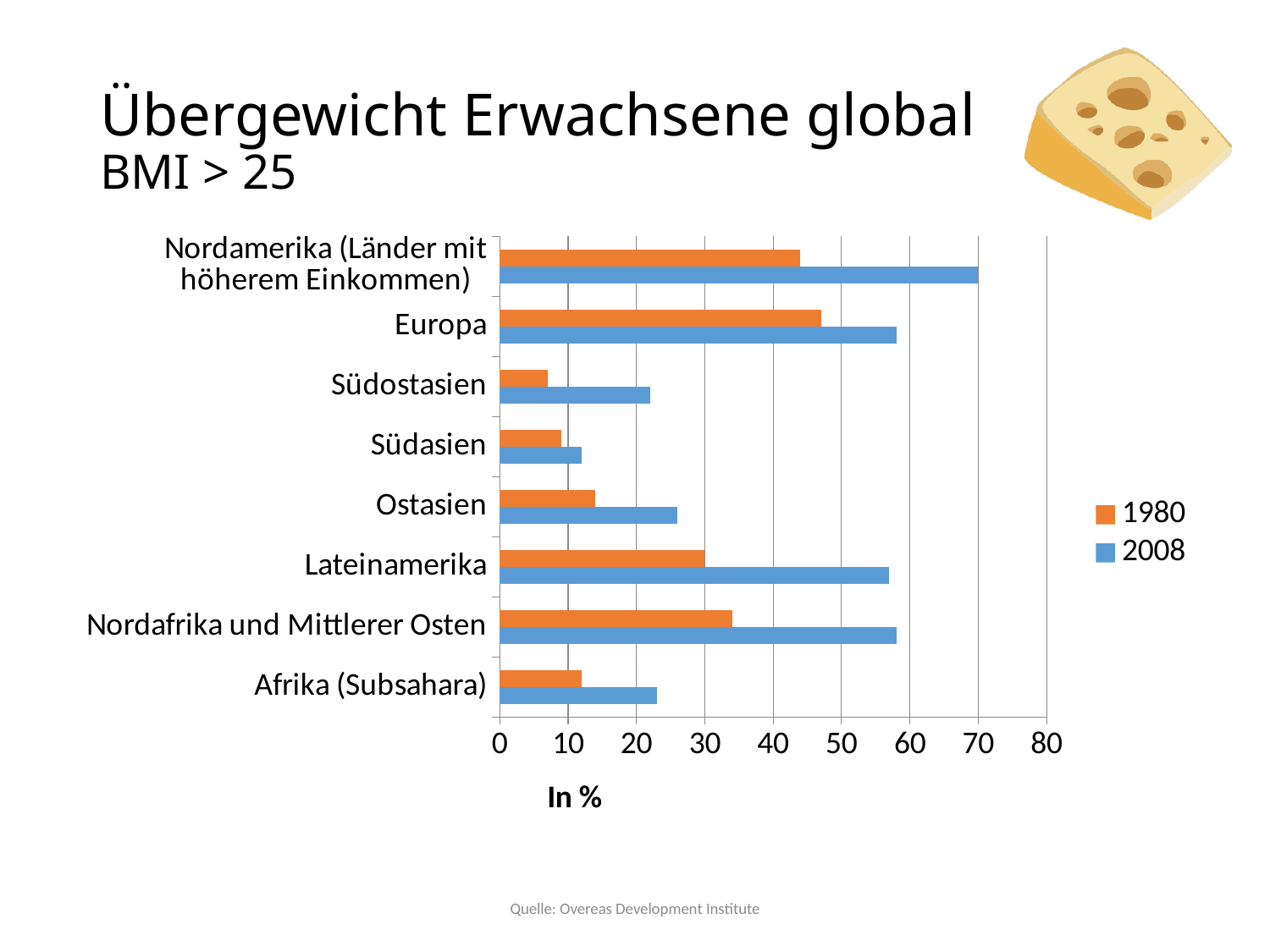
What kind of chart is shown on the slide? bar chart How many series does the legend list? 2 Which region has the lowest value for 2008? Südasien Which is larger: the 2008 value for Ostasien or the 2008 value for Südasien? Ostasien Which region has the highest value for 2008? Nordamerika (Länder mit höherem Einkommen) Is the 1980 value for Südostasien greater or less than 10? less Is the 2008 value for Nordafrika und Mittlerer Osten greater or less than 50? greater Which is larger: the 1980 value for Nordafrika und Mittlerer Osten or the 1980 value for Afrika (Subsahara)? Nordafrika und Mittlerer Osten What are the two series listed in the legend? 1980 and 2008 Is the 2008 value for Europa greater or less than 50? greater How many regions are shown on the chart? 8